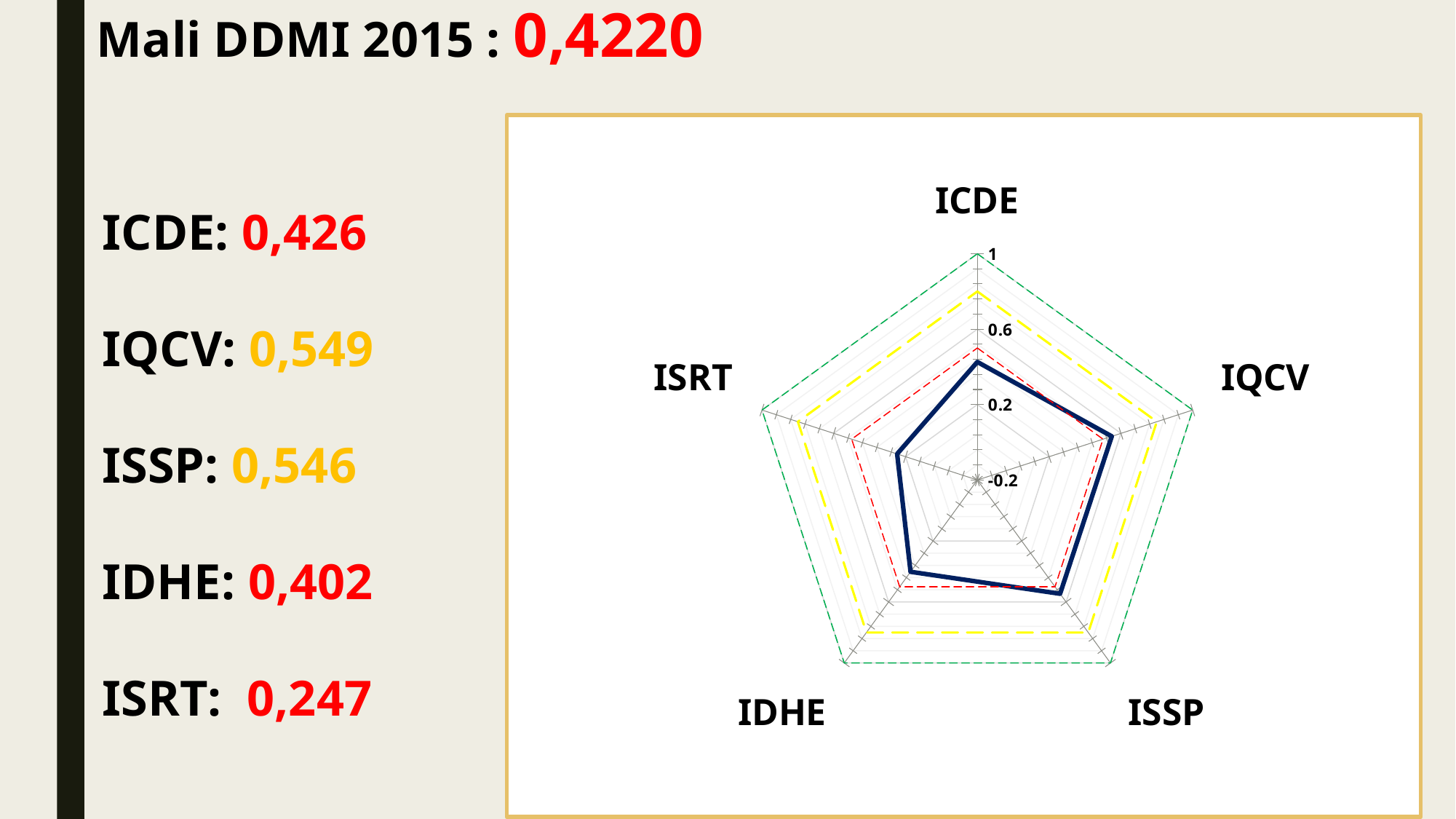
Which is larger, the value for ICDE or the value for ISRT? ICDE What kind of chart is shown on the slide? Radar chart What is the value for ISRT? 0,247 What is the value for IDHE? 0,402 Is the value for ISRT greater or less than 0.6? less What is the Mali DDMI 2015 value shown in the slide title? 0,4220 What is the value for IQCV? 0,549 What is the value for ICDE? 0,426 Which category has the lowest value? ISRT What is the difference between the values for IQCV and ISRT? 0,302 Is the value for ISSP greater or less than 0.2? greater How many categories (axes) does the chart have? 5